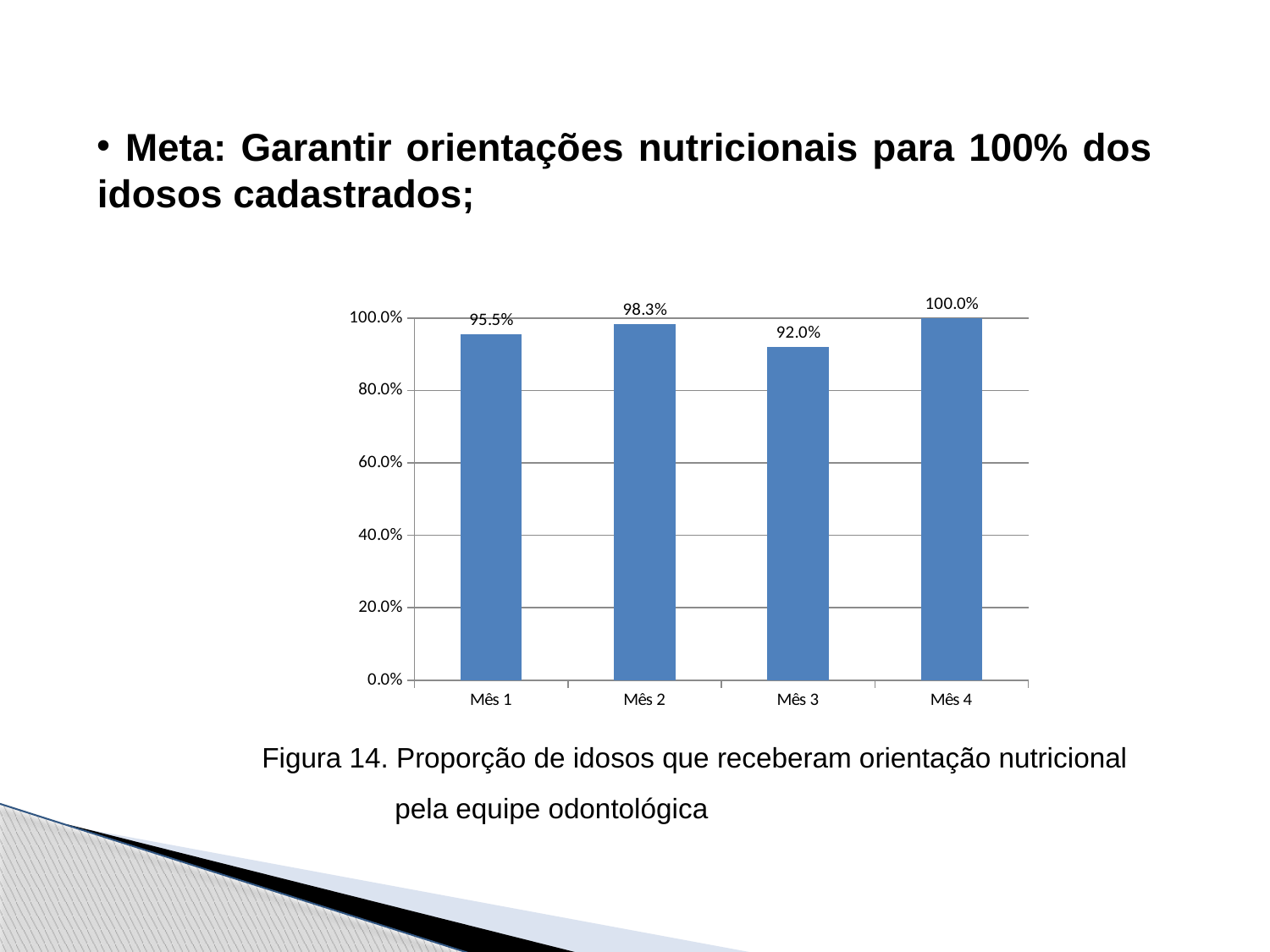
What is the value for Mês 1? 95.5% What is the value for Mês 2? 98.3% Which month has the lowest value? Mês 3 Is the value for Mês 3 greater or less than 80.0%? greater How many months are shown on the x axis? 4 What kind of chart is shown on the slide? Bar chart What is the value for Mês 3? 92.0% What is the difference between the values for Mês 4 and Mês 3? 8.0% Which month has the highest value? Mês 4 Which is larger, the value for Mês 1 or the value for Mês 3? Mês 1 What is the difference between the values for Mês 2 and Mês 1? 2.8% What is the value for Mês 4? 100.0%